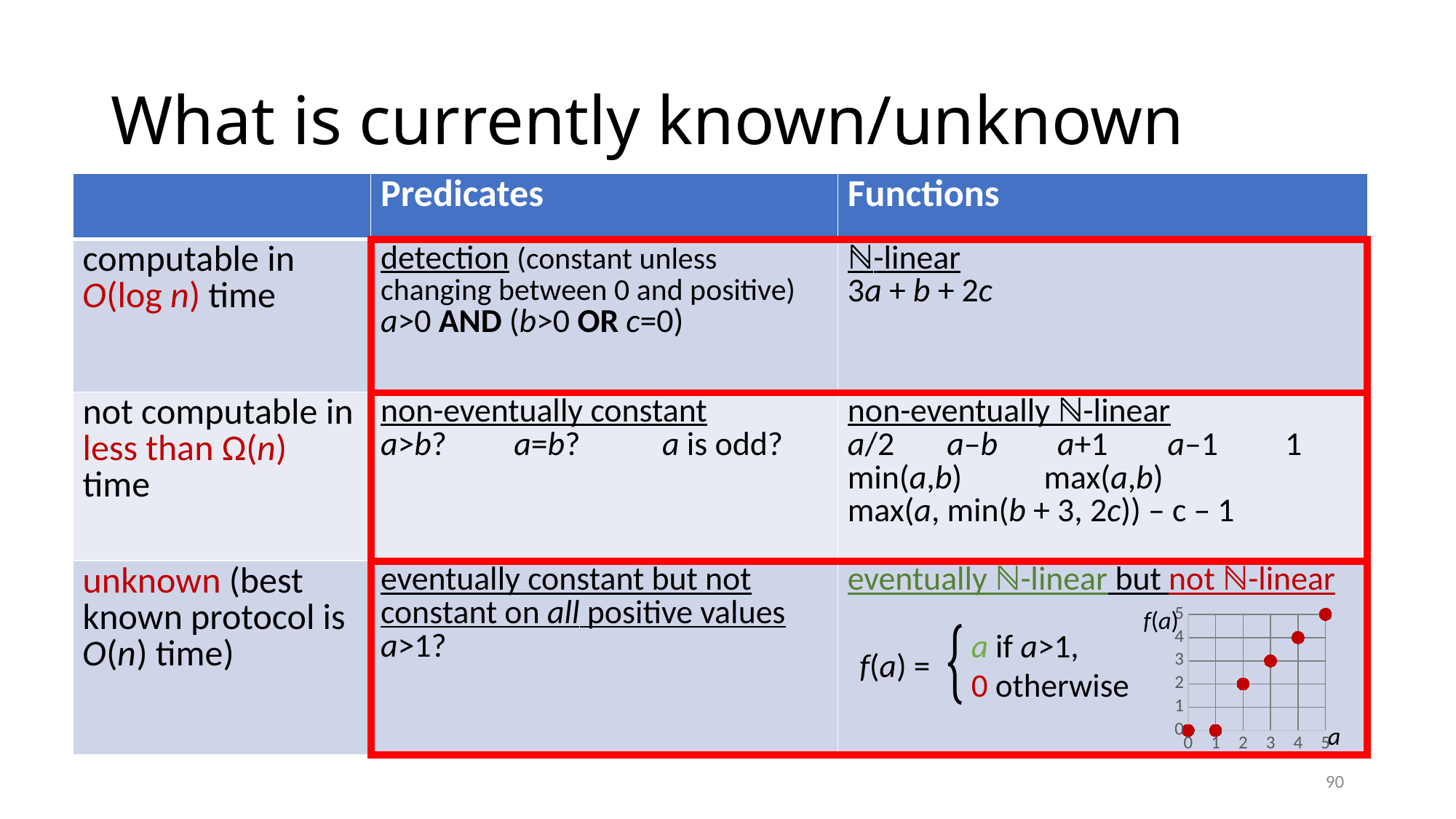
In the small chart of f(a), which is larger: f(a) at a = 2 or f(a) at a = 1? f(a) at a = 2 In the small chart of f(a), what is the difference between f(a) at a = 4 and at a = 2? 2 In the small chart of f(a), at which value of a is f(a) highest? 5 What kind of chart is shown in the bottom-right cell of the table? scatter chart In the small chart of f(a), what is the value of f(a) at a = 5? 5 In the small chart of f(a), what is the value of f(a) at a = 1? 0 In the small chart of f(a), what is the value of f(a) at a = 3? 3 In the small chart of f(a), what is the value of f(a) at a = 0? 0 In the small chart of f(a), what is the label on the vertical axis? f(a) In the small chart of f(a), what colour are the plotted points? red In the small chart of f(a), do the values rise or fall as a increases from 2 to 5? rise In the small chart of f(a), how many data points are plotted? 6